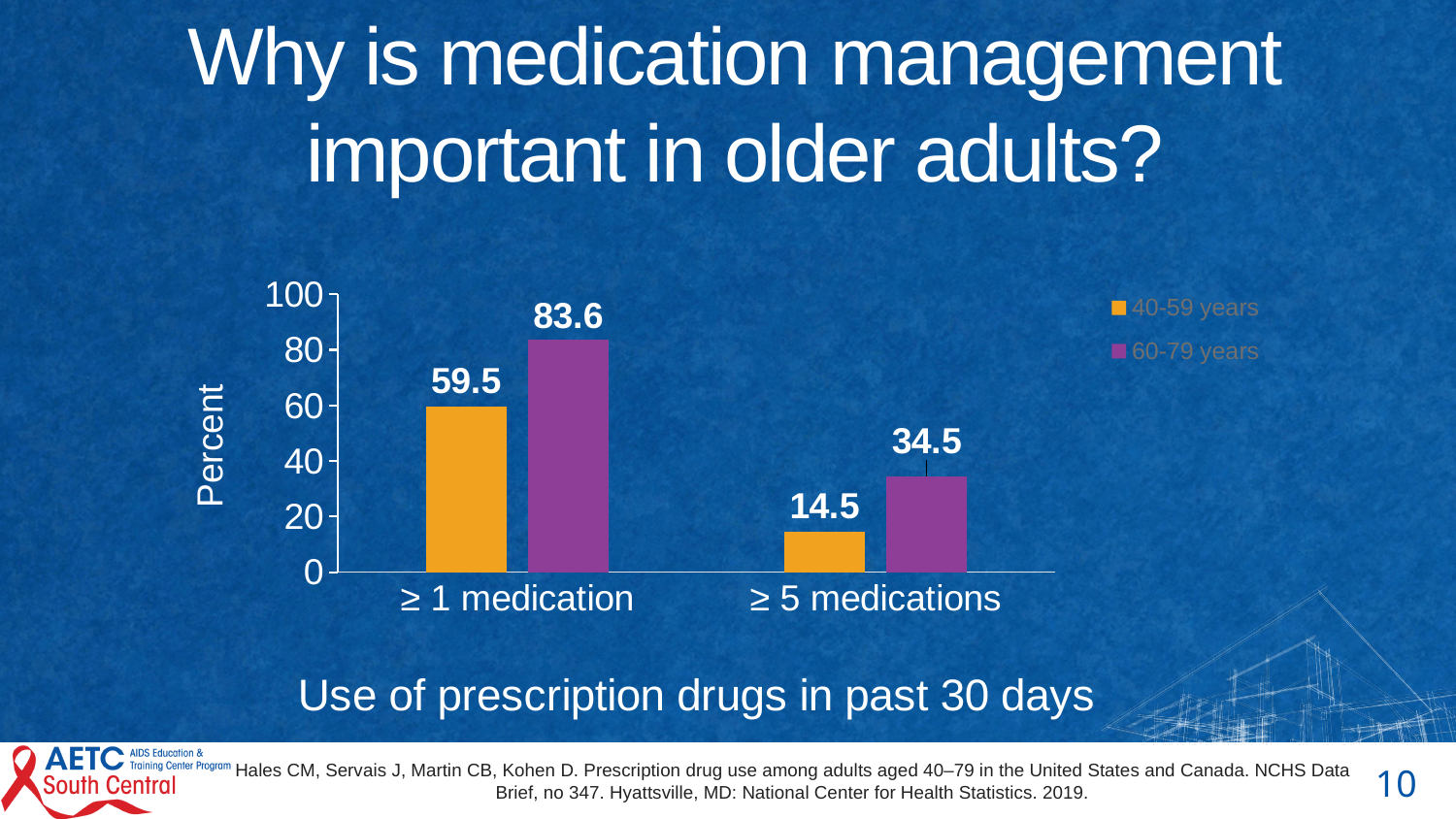
Which is larger for ≥ 5 medications: 40-59 years or 60-79 years? 60-79 years What is the value for 40-59 years in the ≥ 1 medication category? 59.5 What kind of chart is shown on the slide? Bar chart What is the difference between the 60-79 years and 40-59 years values for ≥ 1 medication? 24.1 Which bar has the lowest value on the chart? 40-59 years, ≥ 5 medications How many series does the legend list? 2 What is the difference between the 60-79 years and 40-59 years values for ≥ 5 medications? 20 What is the value for 60-79 years in the ≥ 1 medication category? 83.6 How many categories are shown on the x axis? 2 What is the value for 40-59 years in the ≥ 5 medications category? 14.5 Which bar has the highest value on the chart? 60-79 years, ≥ 1 medication What is the value for 60-79 years in the ≥ 5 medications category? 34.5